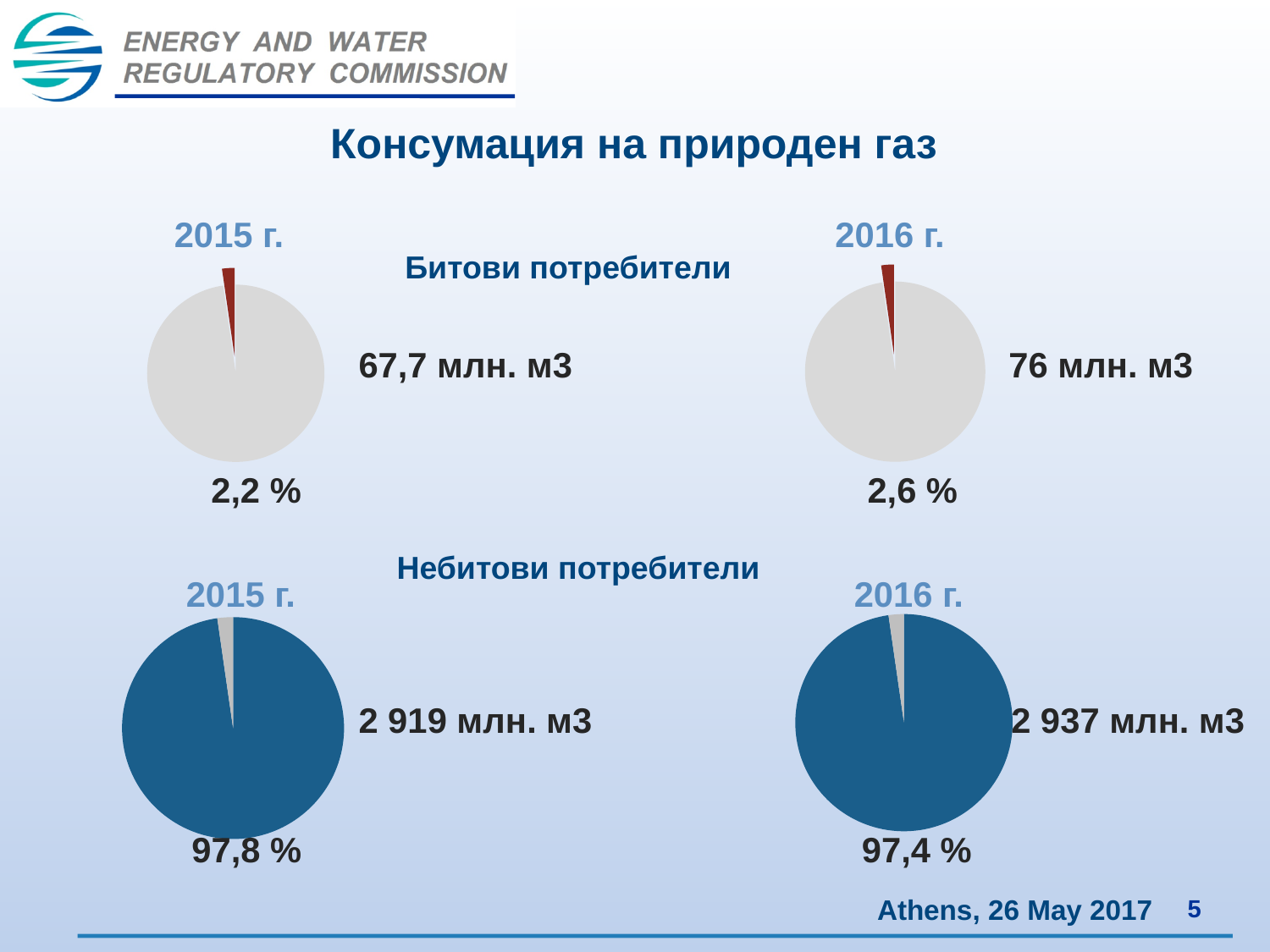
In the bottom-left pie chart (Небитови потребители, 2015 г.), what volume of natural gas is shown? 2 919 млн. м3 How many pie charts are on the slide? 4 In the top-left pie chart (Битови потребители, 2015 г.), what share of consumption is shown for household consumers? 2,2 % What is the title of the slide? Консумация на природен газ In the top-right pie chart (Битови потребители, 2016 г.), what share of consumption is shown for household consumers? 2,6 % In the bottom-left pie chart (Небитови потребители, 2015 г.), what share of consumption is shown for non-household consumers? 97,8 % In the bottom-right pie chart (Небитови потребители, 2016 г.), what volume of natural gas is shown? 2 937 млн. м3 What kind of charts are shown on the slide? Pie charts Comparing the two top pie charts (Битови потребители), which year has the larger household consumption volume, 2015 or 2016? 2016 In the top-right pie chart (Битови потребители, 2016 г.), what volume of natural gas is shown? 76 млн. м3 In the top-left pie chart (Битови потребители, 2015 г.), what volume of natural gas is shown? 67,7 млн. м3